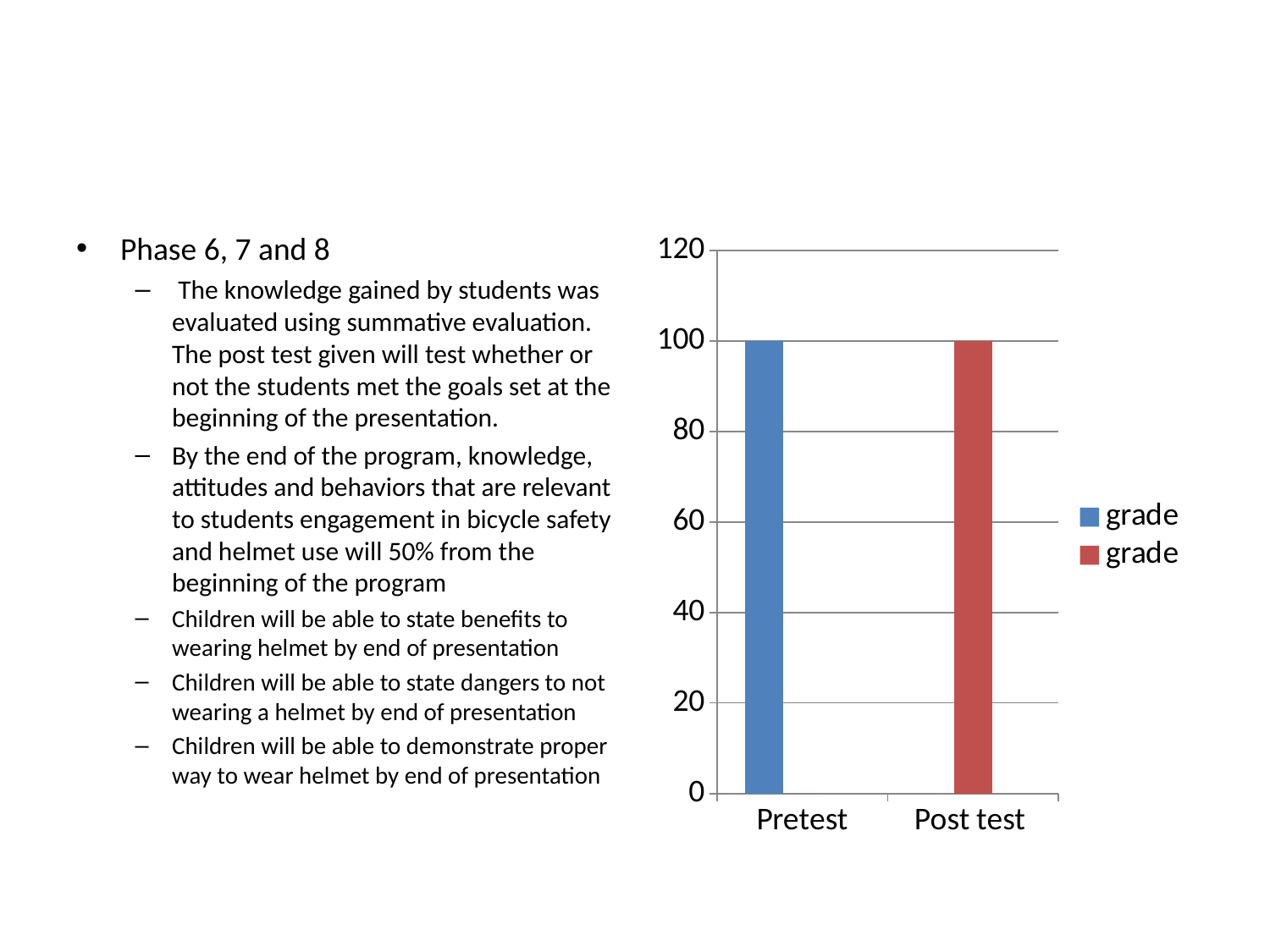
What is the highest value shown on the chart's vertical axis? 120 How many categories are shown on the x axis of the chart? 2 Is the value for Pretest greater or less than 80? greater What kind of chart is shown on the slide? bar chart What colour is the Post test bar? red Is the value for Post test greater or less than 120? less What is the value of the Post test bar? 100 Do the values rise, fall, or stay the same from Pretest to Post test? stay the same What is the difference between the Post test and Pretest values? 0 What label is used for both entries in the chart's legend? grade How many series does the chart's legend list? 2 What is the value of the Pretest bar? 100